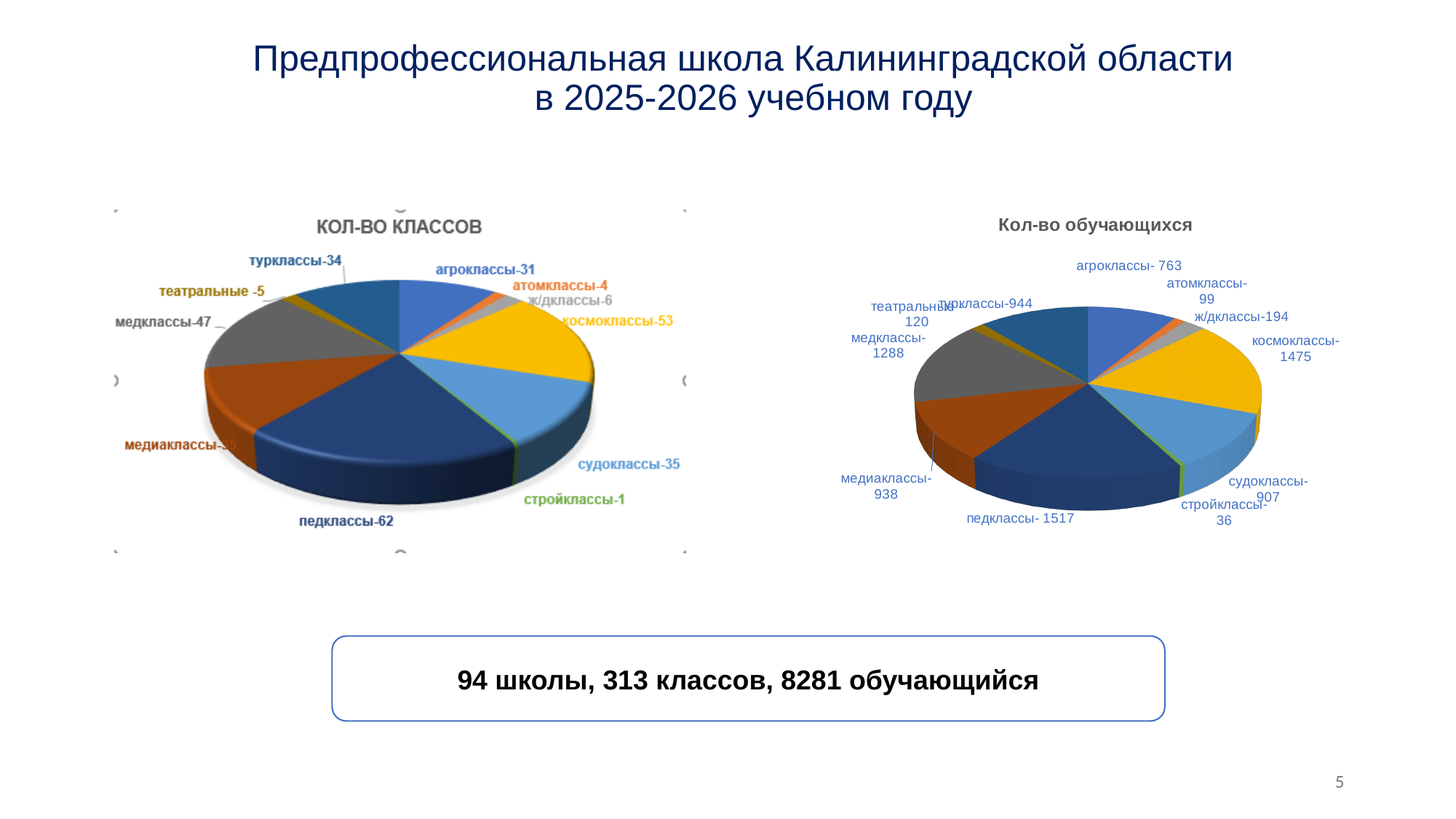
In the "Кол-во обучающихся" chart, what is the value for медклассы? 1288 In the "КОЛ-ВО КЛАССОВ" chart, which category has the largest value? педклассы In the "КОЛ-ВО КЛАССОВ" chart, which category has the smallest value? стройклассы In the "КОЛ-ВО КЛАССОВ" chart, what is the difference between педклассы and космоклассы? 9 In the "Кол-во обучающихся" chart, which category has the largest value? педклассы In the "Кол-во обучающихся" chart, what is the difference between педклассы and космоклассы? 42 In the "КОЛ-ВО КЛАССОВ" chart, what is the value for педклассы? 62 What kind of chart is the "КОЛ-ВО КЛАССОВ" chart on the left? pie chart In the "КОЛ-ВО КЛАССОВ" chart, how many categories are shown? 11 In the "Кол-во обучающихся" chart, what is the value for турклассы? 944 In the "КОЛ-ВО КЛАССОВ" chart, what is the value for космоклассы? 53 In the "Кол-во обучающихся" chart, which is larger: судоклассы or медиаклассы? медиаклассы